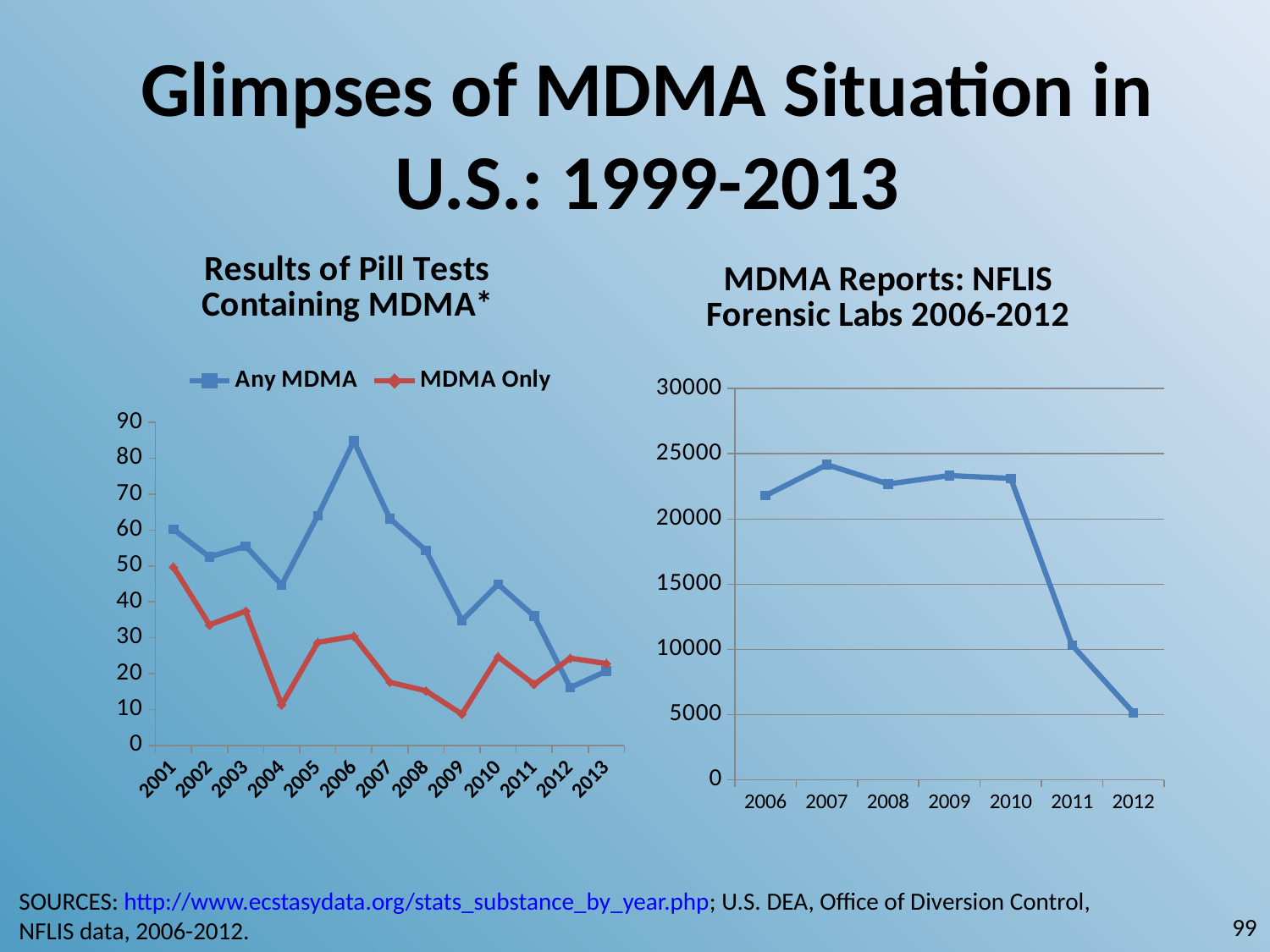
In the 'MDMA Reports: NFLIS Forensic Labs 2006-2012' chart, which year has the lowest value? 2012 In the 'MDMA Reports: NFLIS Forensic Labs 2006-2012' chart, do the values rise or fall from 2010 to 2012? fall In the 'Results of Pill Tests Containing MDMA*' chart, is the Any MDMA value for 2006 greater or less than 80? greater What kind of chart is the 'Results of Pill Tests Containing MDMA*' chart? line chart In the 'MDMA Reports: NFLIS Forensic Labs 2006-2012' chart, which year has the highest value? 2007 In the 'Results of Pill Tests Containing MDMA*' chart, in which year is the Any MDMA series highest? 2006 How many years are plotted on the x axis of the 'Results of Pill Tests Containing MDMA*' chart? 13 In the 'Results of Pill Tests Containing MDMA*' chart, in which year is the MDMA Only series lowest? 2009 In the 'MDMA Reports: NFLIS Forensic Labs 2006-2012' chart, is the value for 2012 greater or less than 10000? less In the 'Results of Pill Tests Containing MDMA*' chart, which series is higher in 2005, Any MDMA or MDMA Only? Any MDMA In the 'Results of Pill Tests Containing MDMA*' chart, is the Any MDMA value for 2009 greater or less than 40? less How many series does the legend of the 'Results of Pill Tests Containing MDMA*' chart list? 2